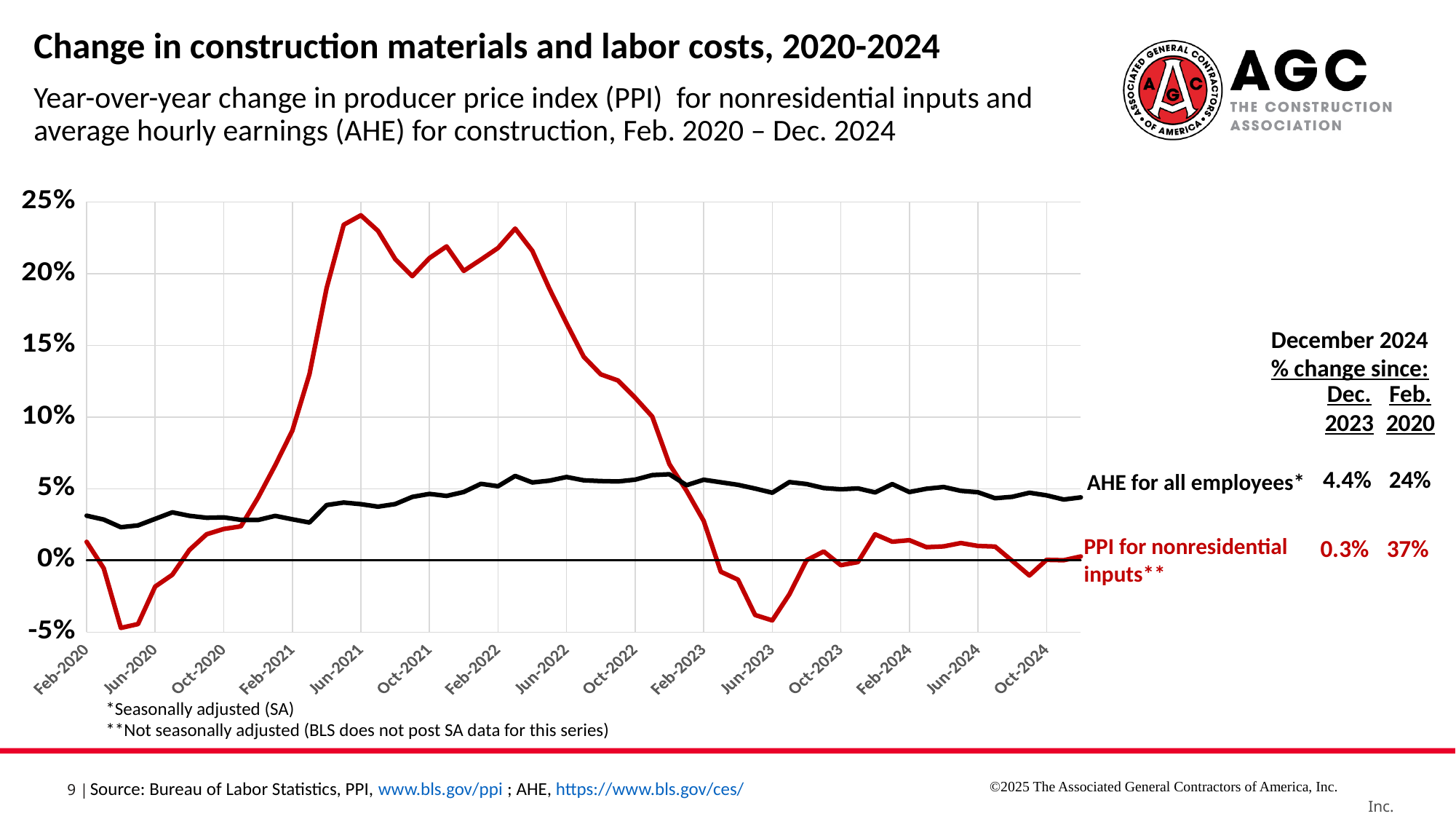
What kind of chart is shown on the slide? line chart According to the table on the right, what is the December 2024 % change since Feb. 2020 for PPI for nonresidential inputs? 37% Which series shows the larger % change since Feb. 2020 in the table on the right, AHE for all employees or PPI for nonresidential inputs? PPI for nonresidential inputs Does the PPI for nonresidential inputs line rise or fall between Jun-2021 and Feb-2023? fall What is the difference between the % change since Feb. 2020 for PPI for nonresidential inputs (37%) and for AHE for all employees (24%)? 13 percentage points What is the title of the slide's chart? Change in construction materials and labor costs, 2020-2024 Is the peak value of the PPI for nonresidential inputs line around Jun-2021 greater or less than 20%? greater Is the value of the PPI for nonresidential inputs line at Jun-2020 greater or less than 0%? less According to the table on the right, what is the December 2024 % change since Dec. 2023 for AHE for all employees? 4.4% Which colour is used for the PPI for nonresidential inputs line? red At Jun-2023, which line is higher, AHE for all employees or PPI for nonresidential inputs? AHE for all employees How many data series are plotted on the chart? 2